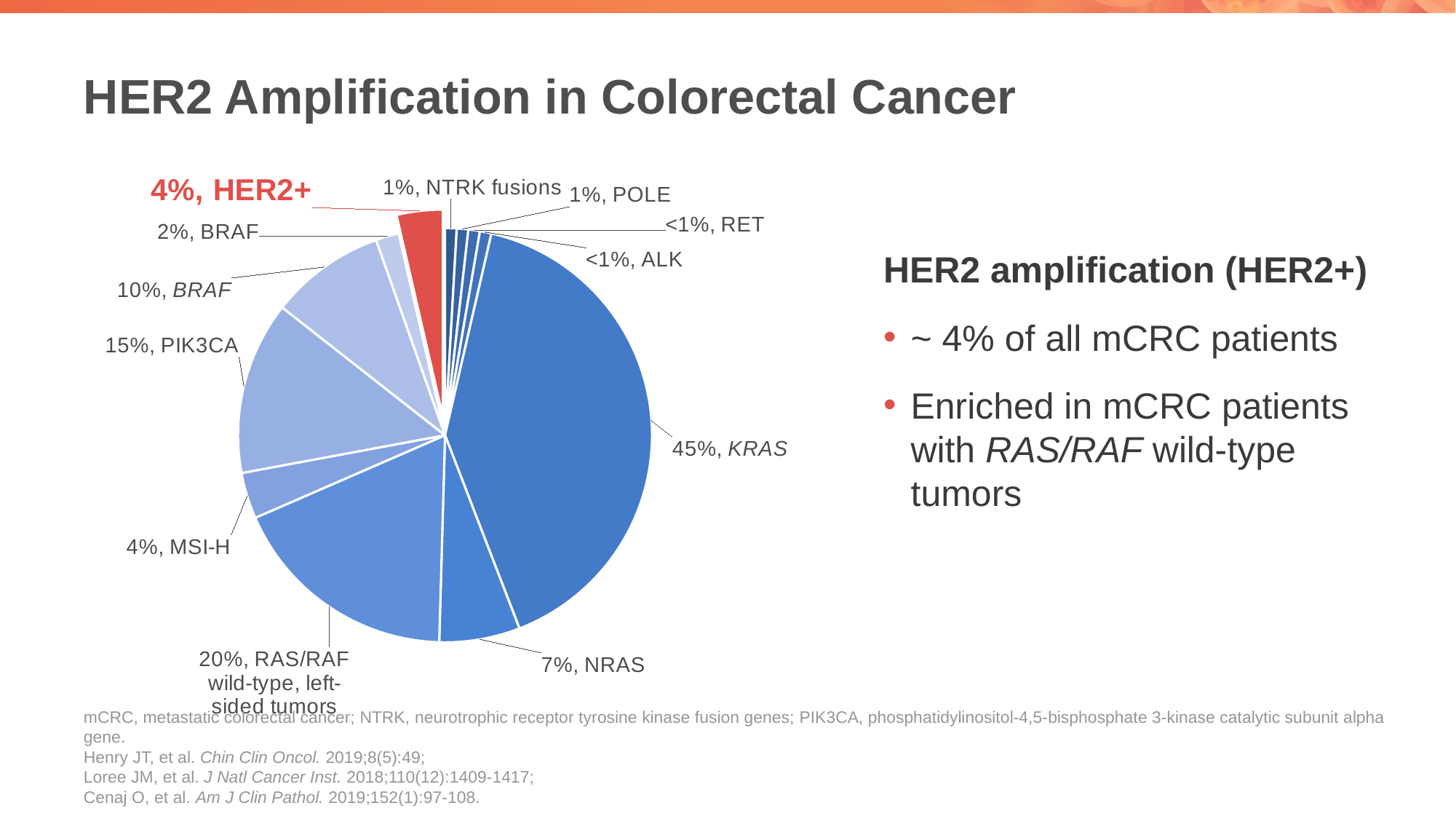
How many slices are labelled in the pie chart? 12 Which category has the largest slice of the pie chart? KRAS What percentage is shown for RAS/RAF wild-type, left-sided tumors in the pie chart? 20% Which slice is larger in the pie chart: PIK3CA or MSI-H? PIK3CA What percentage is shown for NRAS in the pie chart? 7% What percentage is shown for PIK3CA in the pie chart? 15% Which slice of the pie chart is coloured red and pulled out from the rest? HER2+ What is the difference between the KRAS and NRAS percentages in the pie chart? 38% What kind of chart is shown on the slide? pie chart What share of the pie does MSI-H represent? 4% What percentage is shown for HER2+ in the pie chart? 4% What percentage is shown for KRAS in the pie chart? 45%